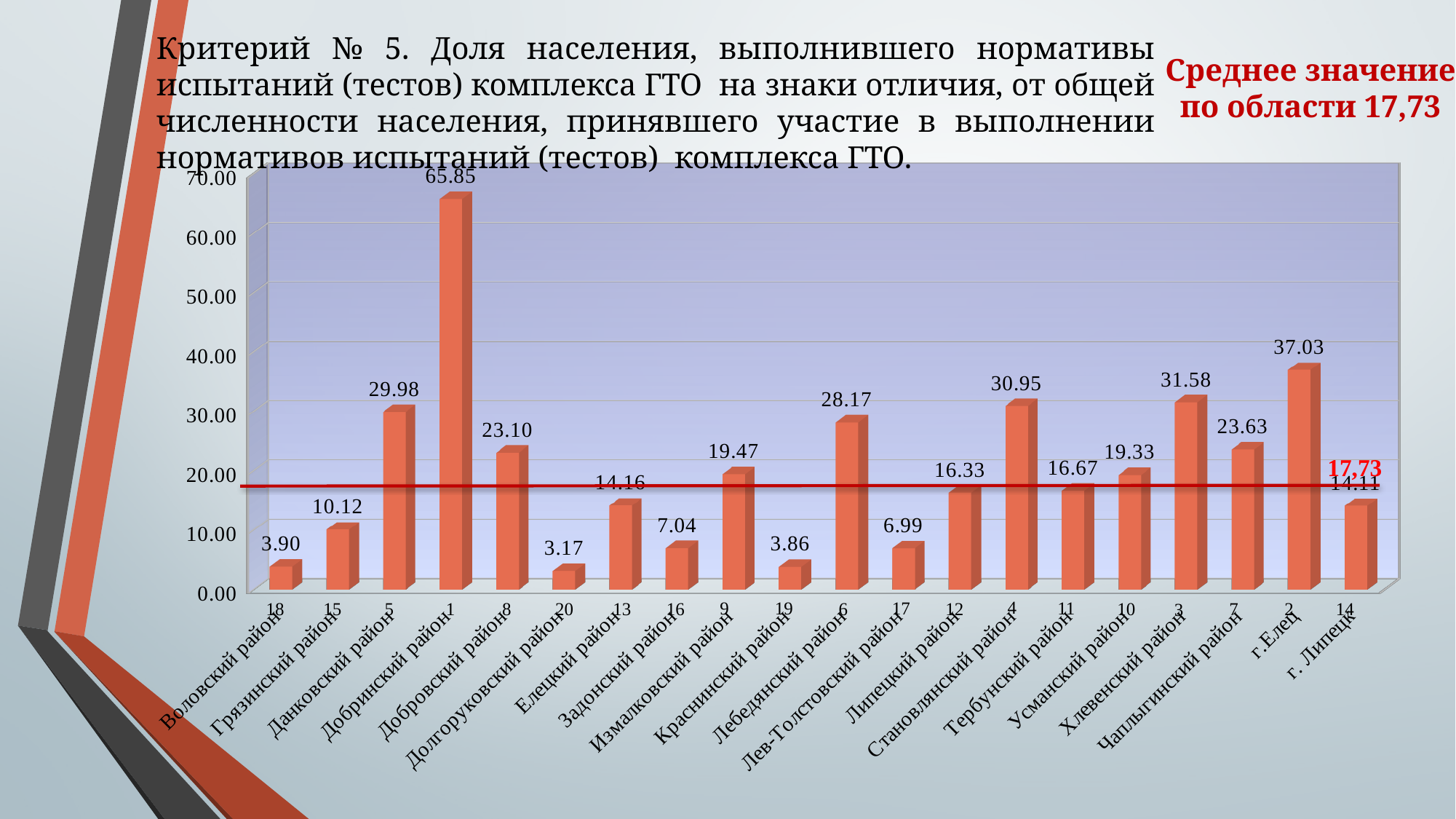
What is the difference between the values for Хлевенский район and Усманский район? 12.25 Which district has the lowest value? Долгоруковский район What is the value for Долгоруковский район? 3.17 Which is larger, the value for Данковский район or the value for Лебедянский район? Данковский район How many districts are shown on the chart? 20 What is the value for Добринский район? 65.85 What is the value for г.Елец? 37.03 Which district has the highest value? Добринский район What kind of chart is shown on the slide? bar chart What value does the red horizontal line on the chart mark? 17,73 Is the value for Чаплыгинский район greater or less than 20.00? greater What is the value for Становлянский район? 30.95